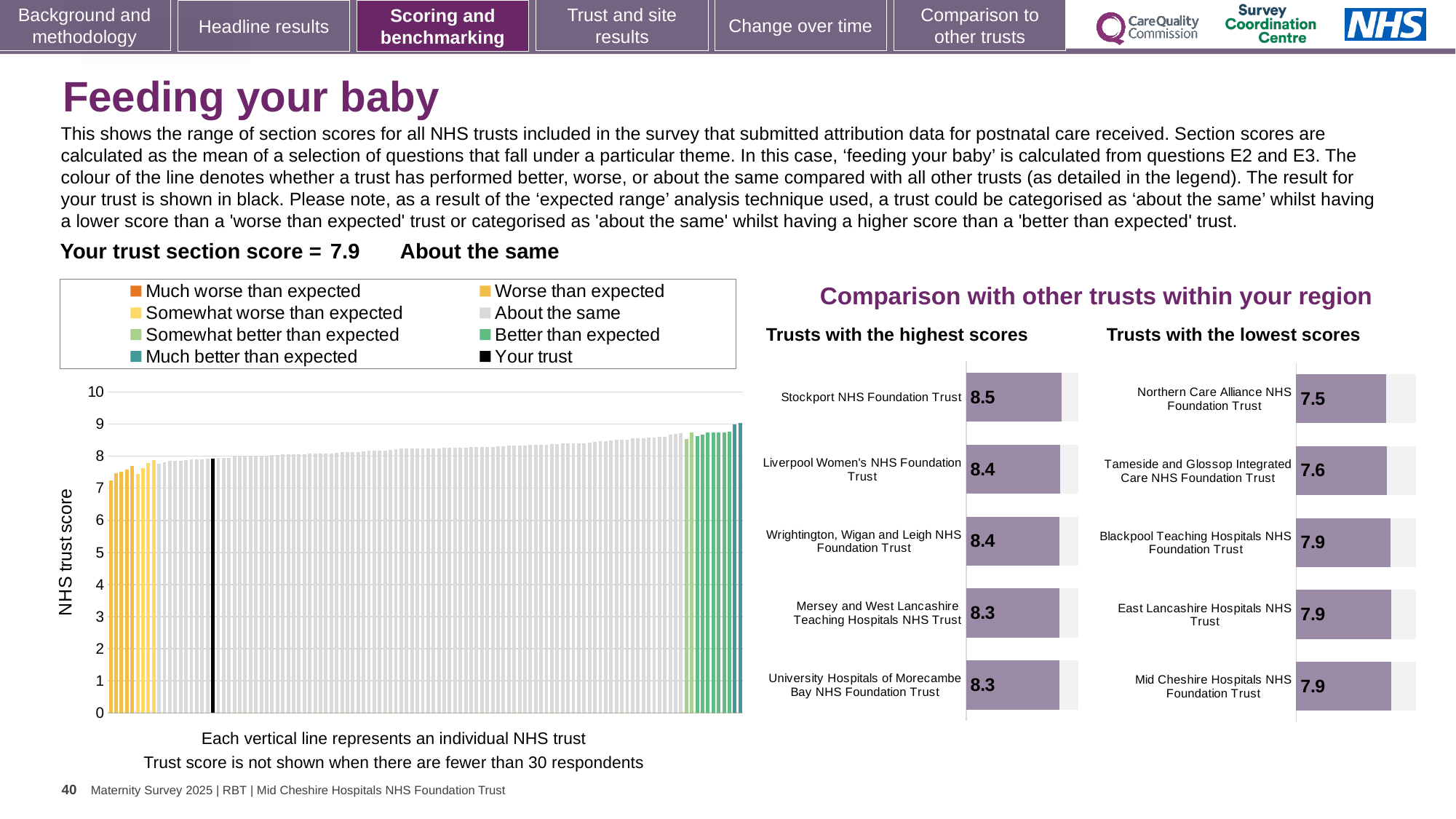
In the 'Trusts with the lowest scores' chart, which has the larger score: Tameside and Glossop Integrated Care NHS Foundation Trust or Northern Care Alliance NHS Foundation Trust? Tameside and Glossop Integrated Care NHS Foundation Trust In the 'Trusts with the highest scores' chart, what is the difference between the scores of Stockport NHS Foundation Trust and University Hospitals of Morecambe Bay NHS Foundation Trust? 0.2 In the 'Trusts with the highest scores' chart, what is the score for Stockport NHS Foundation Trust? 8.5 How many entries does the legend above the large 'NHS trust score' chart list? 8 What kind of chart is the large 'NHS trust score' chart on the left of the slide? Bar chart In the 'Trusts with the lowest scores' chart, what is the score for Blackpool Teaching Hospitals NHS Foundation Trust? 7.9 In the 'Trusts with the highest scores' chart, which trust has the highest score? Stockport NHS Foundation Trust In the 'Trusts with the lowest scores' chart, what is the difference between the scores of Mid Cheshire Hospitals NHS Foundation Trust and Northern Care Alliance NHS Foundation Trust? 0.4 In the 'Trusts with the lowest scores' chart, which trust has the lowest score? Northern Care Alliance NHS Foundation Trust In the 'Trusts with the lowest scores' chart, what is the score for Northern Care Alliance NHS Foundation Trust? 7.5 In the large 'NHS trust score' chart on the left, do the values rise or fall from left to right? Rise In the 'Trusts with the highest scores' chart, how many trusts are shown? 5